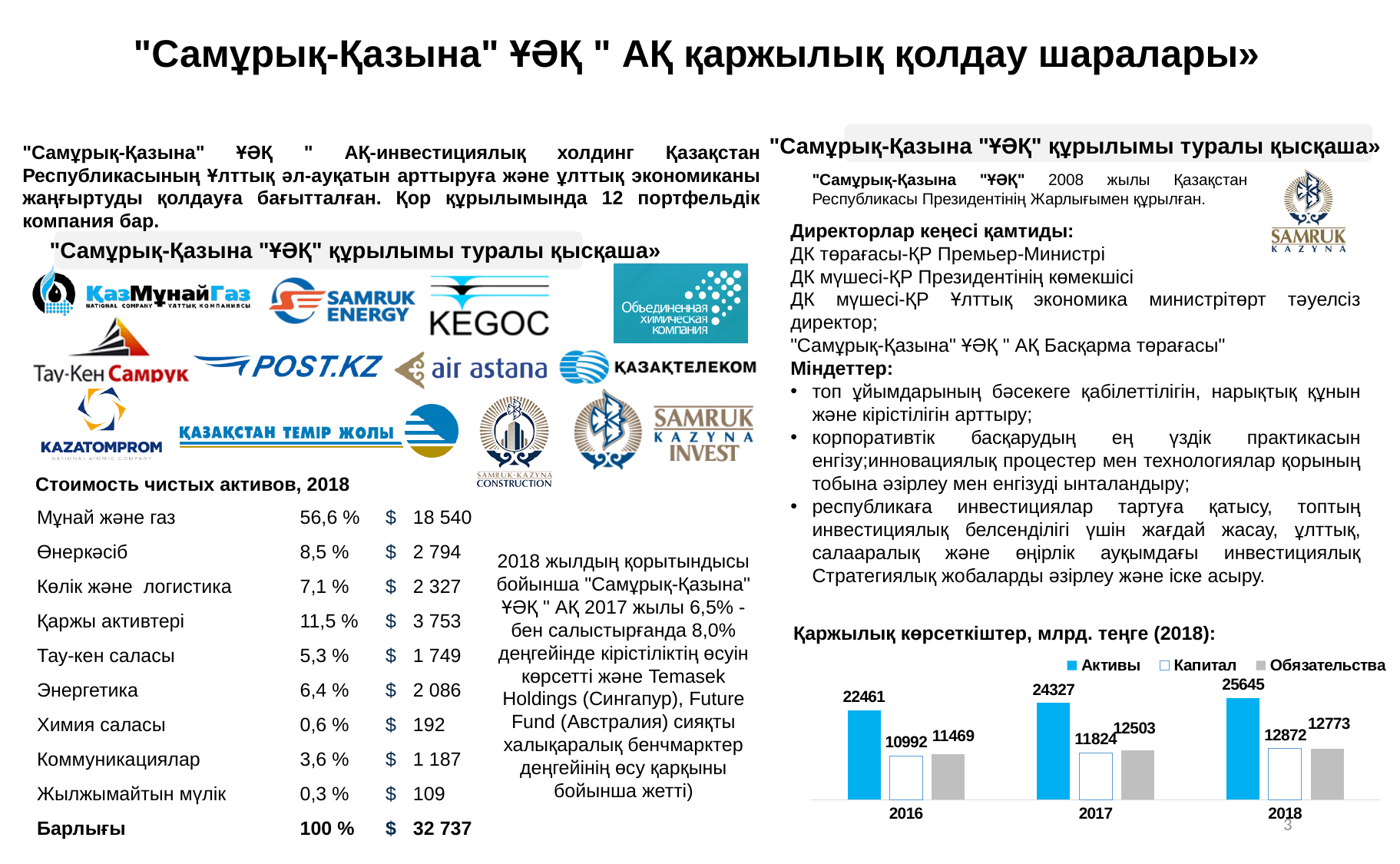
What type of chart is shown under the title "Қаржылық көрсеткіштер, млрд. теңге (2018)"? Bar chart In the "Қаржылық көрсеткіштер" chart, what is the difference between Активы in 2018 and Активы in 2016? 3184 In the "Қаржылық көрсеткіштер" chart, what is the value of Обязательства for 2017? 12503 In the "Қаржылық көрсеткіштер" chart, which year has the highest value for Активы? 2018 In the "Қаржылық көрсеткіштер" chart, do the Активы values rise or fall from 2016 to 2018? Rise In the "Қаржылық көрсеткіштер" chart, what is the value of Капитал for 2016? 10992 In the "Қаржылық көрсеткіштер" chart, which year has the lowest value for Капитал? 2016 In the "Қаржылық көрсеткіштер" chart, which series is shown in grey? Обязательства How many series does the legend of the "Қаржылық көрсеткіштер" chart list? 3 In the "Қаржылық көрсеткіштер" chart, what is the value of Активы for 2018? 25645 How many years are shown on the x axis of the "Қаржылық көрсеткіштер" chart? 3 In the "Қаржылық көрсеткіштер" chart, which is larger in 2018: Капитал or Обязательства? Капитал